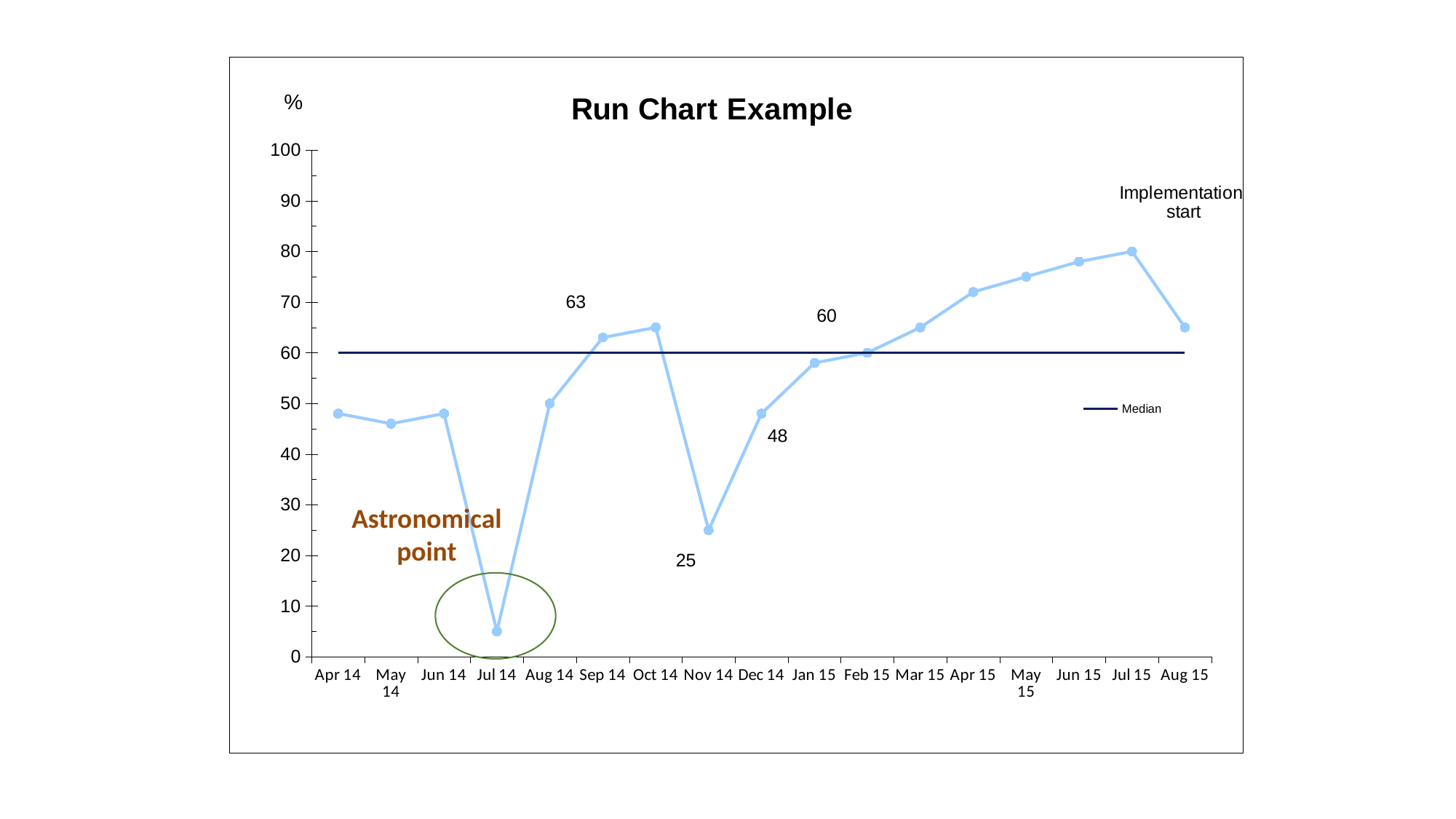
What is the value for Dec 14? 48 What type of chart is shown on the slide? Line chart Which is larger, the value for Sep 14 or the value for Nov 14? Sep 14 What is the value for Sep 14? 63 What is the value for Feb 15? 60 Which month has the lowest value on the chart? Jul 14 What is the title of the chart? Run Chart Example What is the difference between the values for Sep 14 and Nov 14? 38 What is the value for Nov 14? 25 How many months are plotted along the x axis? 17 Which month is circled and labelled as the 'Astronomical point'? Jul 14 Is the value for Apr 15 greater or less than 70? greater